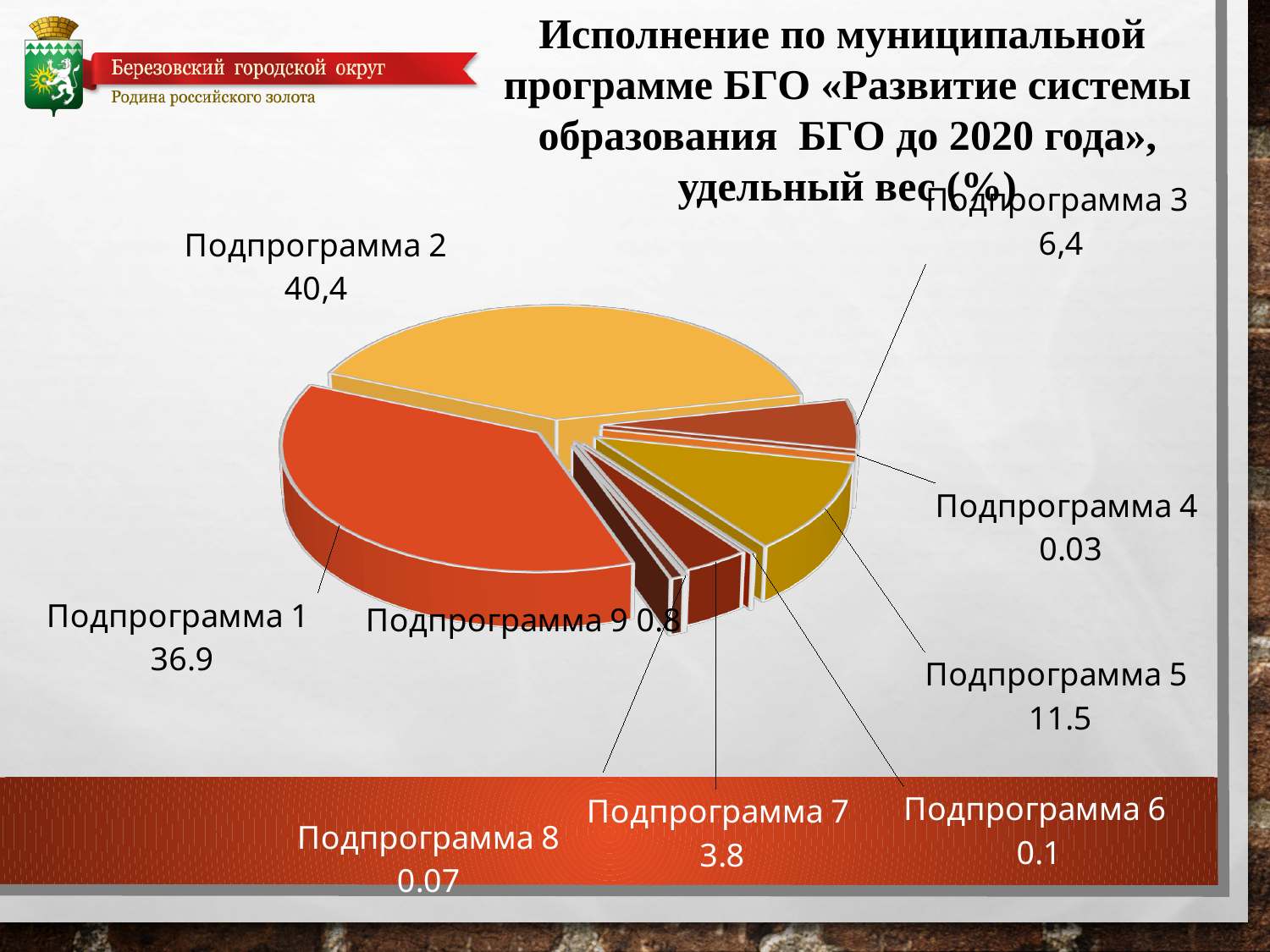
What is the value for Подпрограмма 5? 11.5 What is the value for Подпрограмма 7? 3.8 What is the value for Подпрограмма 1? 36.9 What kind of chart is shown on the slide? pie chart What is the value for Подпрограмма 2? 40,4 How many slices does the pie chart have? 9 Which subprogram has the smallest share of the pie? Подпрограмма 4 What is the value for Подпрограмма 4? 0.03 What is the difference between the values for Подпрограмма 5 and Подпрограмма 7? 7.7 Which subprogram has the largest share of the pie? Подпрограмма 2 What unit does the chart title say the values are expressed in? удельный вес (%) Which is larger, the value for Подпрограмма 3 or the value for Подпрограмма 5? Подпрограмма 5